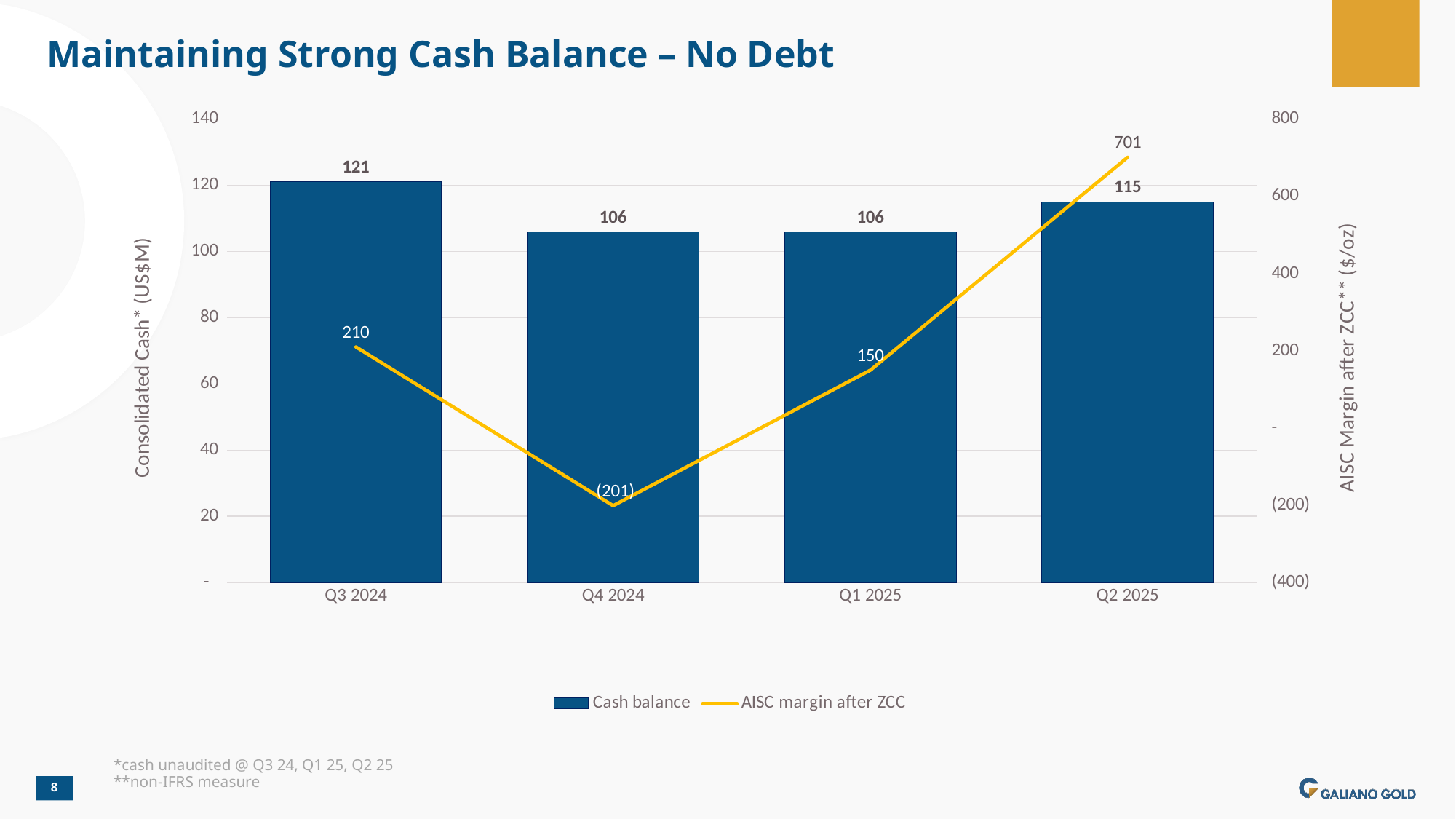
What is the difference in cash balance between Q3 2024 and Q2 2025? 6 What is the cash balance for Q3 2024? 121 Which quarter has the highest cash balance? Q3 2024 How many quarters are shown on the x axis? 4 Does the AISC margin after ZCC rise or fall from Q4 2024 to Q2 2025? Rise Which quarter has the lowest AISC margin after ZCC? Q4 2024 How many series does the legend list? 2 What is the AISC margin after ZCC for Q2 2025? 701 What is the AISC margin after ZCC for Q4 2024? (201) What kind of chart is used to show the cash balance? Bar chart What is the title of the chart slide? Maintaining Strong Cash Balance – No Debt Is the cash balance higher in Q2 2025 or Q1 2025? Q2 2025